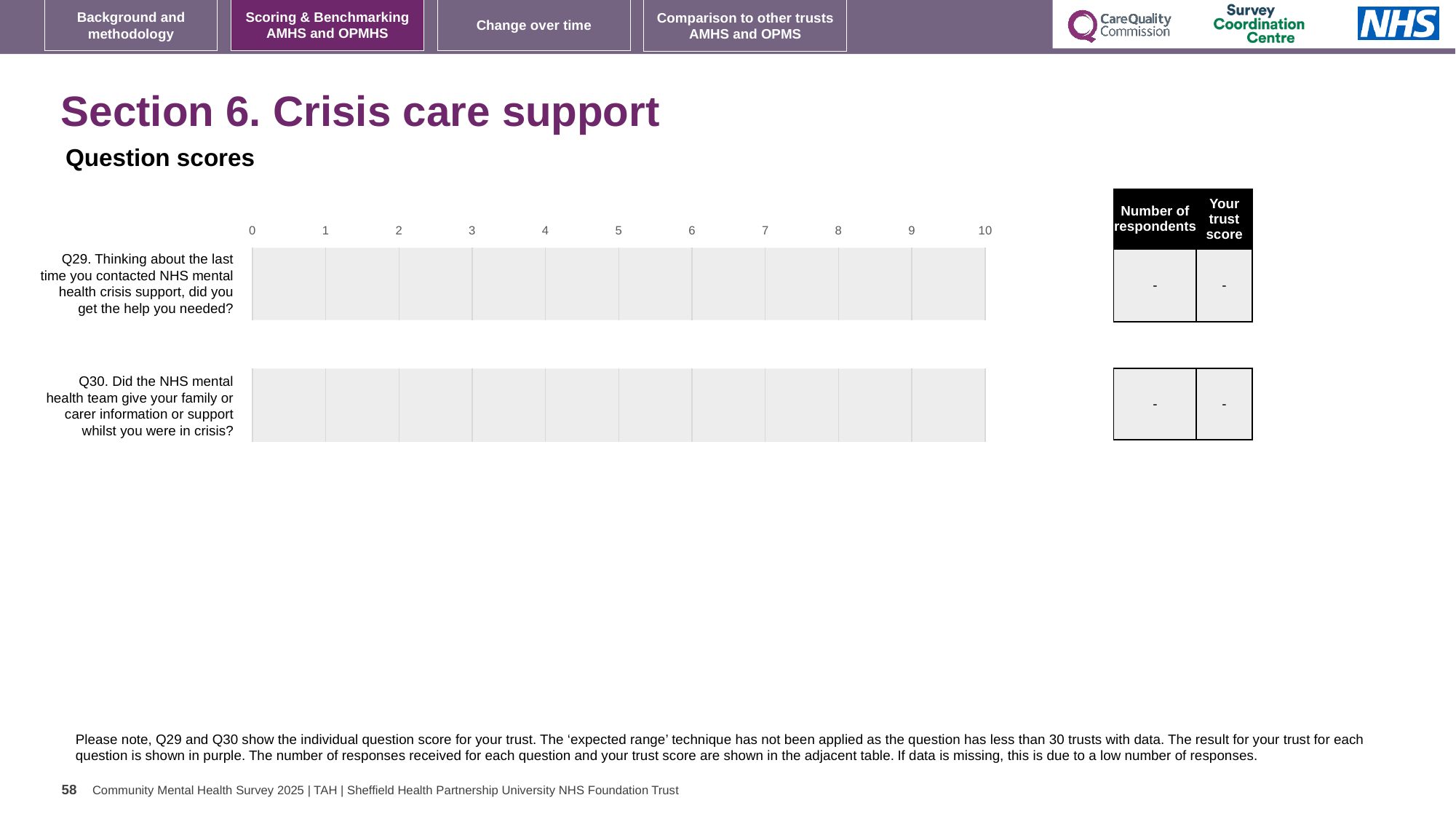
How many questions are listed as categories on the chart? 2 What is the maximum value shown on the chart's x axis? 10 What is the minimum value shown on the chart's x axis? 0 What type of chart is used to show the question scores? bar chart Which question number is the first category on the chart? Q29 What is shown in the 'Number of respondents' column for Q30? - What is shown in the 'Your trust score' column for Q29? - Which question number is the second category on the chart? Q30